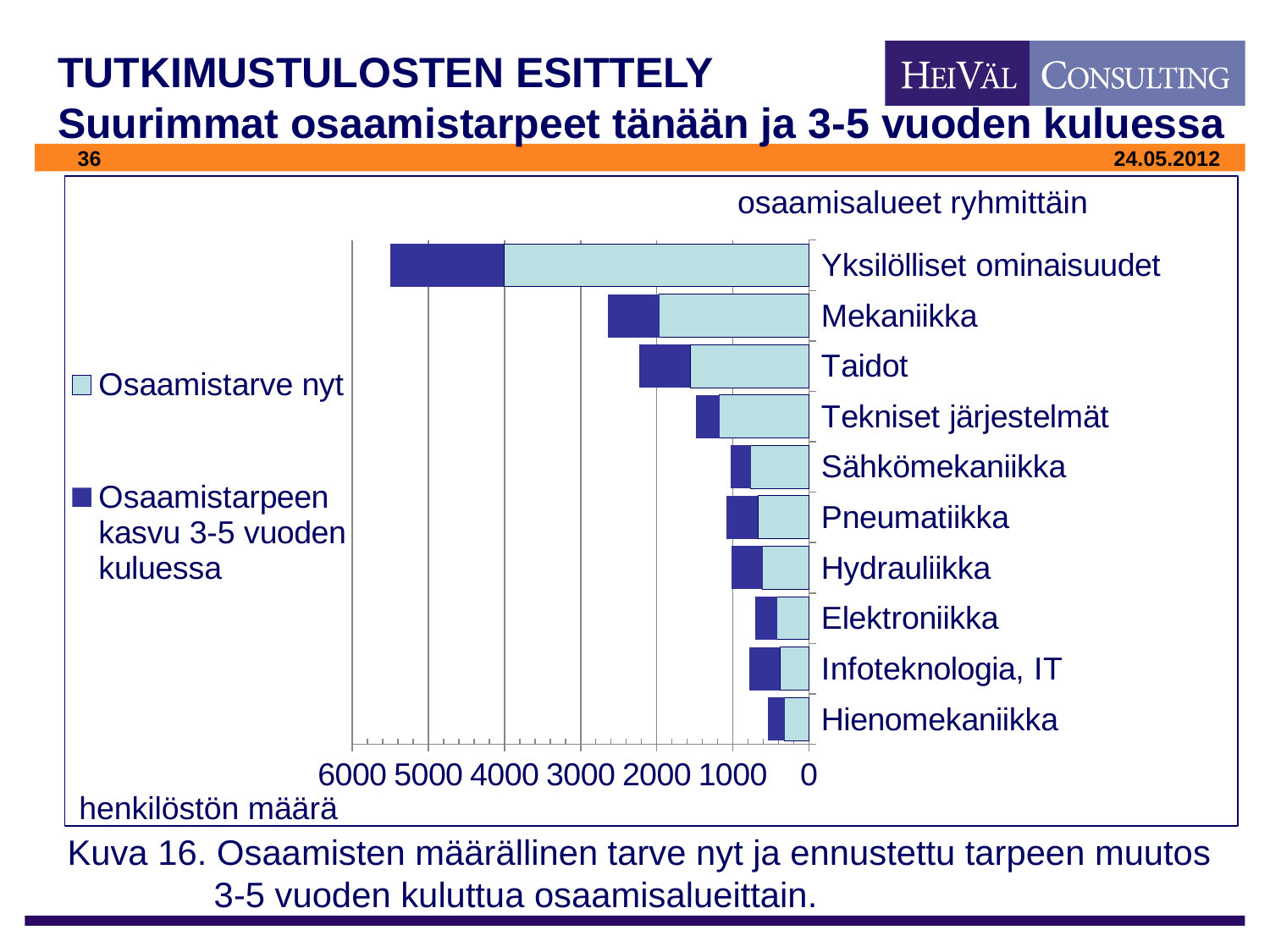
Which category has the shortest total bar? Hienomekaniikka How many categories (osaamisalueet) are plotted in the chart? 10 Is the total bar for Yksilölliset ominaisuudet greater or less than 5000? greater What kind of chart is shown on the slide? Stacked horizontal bar chart What is the label on the horizontal axis of the chart? henkilöstön määrä Is the total bar for Mekaniikka greater or less than 2000? greater Which has the longer total bar, Mekaniikka or Taidot? Mekaniikka Is the total bar for Hienomekaniikka greater or less than 1000? less Which legend entry is shown in dark blue? Osaamistarpeen kasvu 3-5 vuoden kuluessa Which category has the longest total bar? Yksilölliset ominaisuudet How many series does the legend list? 2